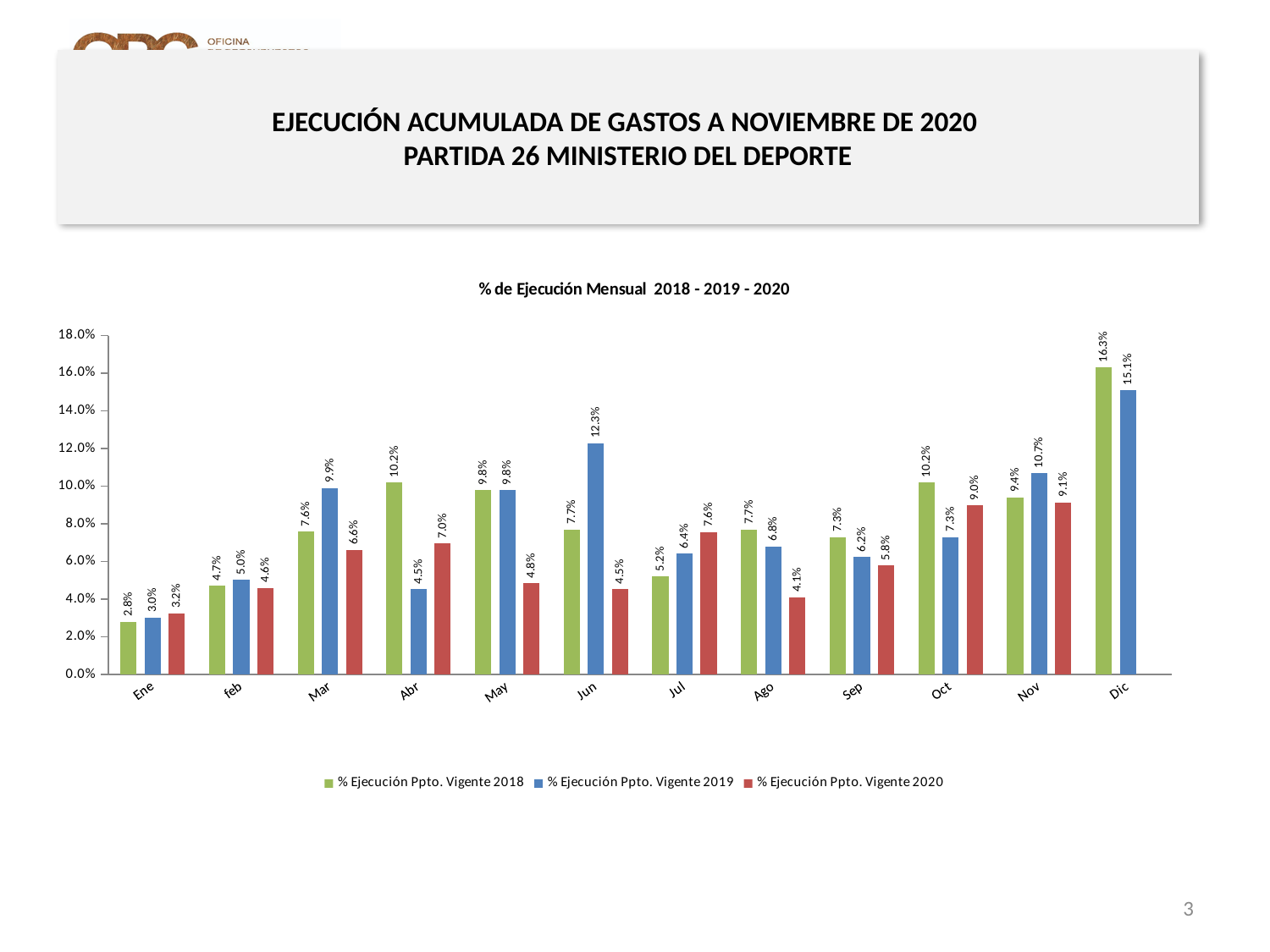
What is the value for % Ejecución Ppto. Vigente 2018 in Abr? 10.2% What is the value for % Ejecución Ppto. Vigente 2019 in Jun? 12.3% What is the value for % Ejecución Ppto. Vigente 2020 in Oct? 9.0% How many months are shown on the x axis? 12 What is the title of the chart? % de Ejecución Mensual 2018 - 2019 - 2020 Which month has the highest value for % Ejecución Ppto. Vigente 2018? Dic Which is larger in Jul: the 2018 value or the 2020 value? 2020 value (7.6%) Is the value for % Ejecución Ppto. Vigente 2019 in Nov greater or less than 10.0%? greater Which month has the lowest value for % Ejecución Ppto. Vigente 2020? Ene What is the difference between the 2018 and 2019 values in Dic? 1.2% What kind of chart is shown on the slide? Bar chart How many series does the legend list? 3